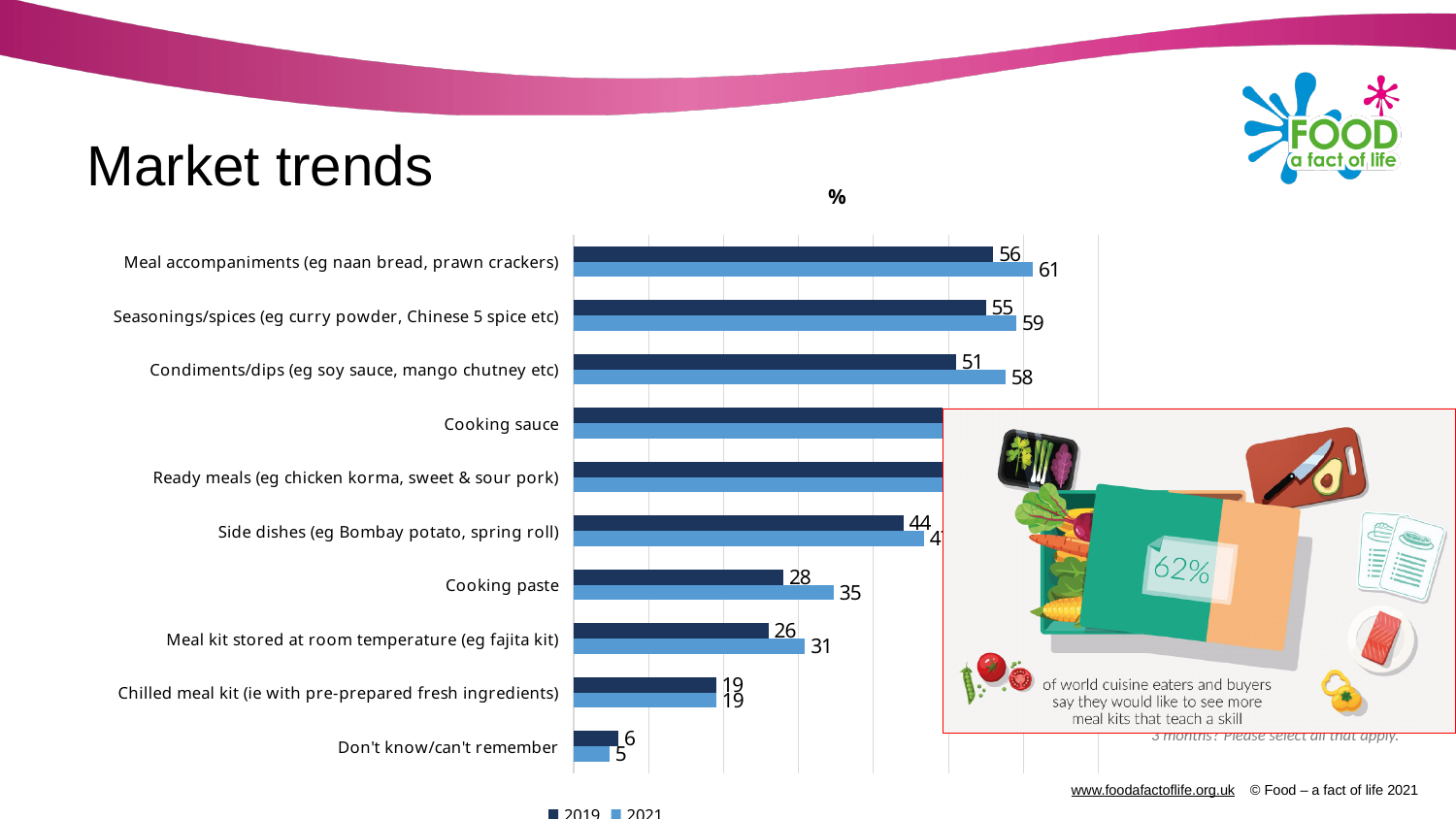
Which is larger: the 2021 value for Cooking paste or the 2021 value for Meal kit stored at room temperature (eg fajita kit)? Cooking paste Which category has the lowest 2019 value? Don't know/can't remember What kind of chart is shown on the slide? Bar chart How many categories are plotted on the chart? 10 Which category has the highest 2021 value? Meal accompaniments (eg naan bread, prawn crackers) What are the two years listed in the chart legend? 2019 and 2021 What is the 2021 value for Cooking paste? 35 What is the difference between the 2021 and 2019 values for Condiments/dips (eg soy sauce, mango chutney etc)? 7 What is the 2019 value for Meal kit stored at room temperature (eg fajita kit)? 26 How many series does the chart legend list? 2 What is the 2021 value for Meal accompaniments (eg naan bread, prawn crackers)? 61 What is the 2019 value for Seasonings/spices (eg curry powder, Chinese 5 spice etc)? 55